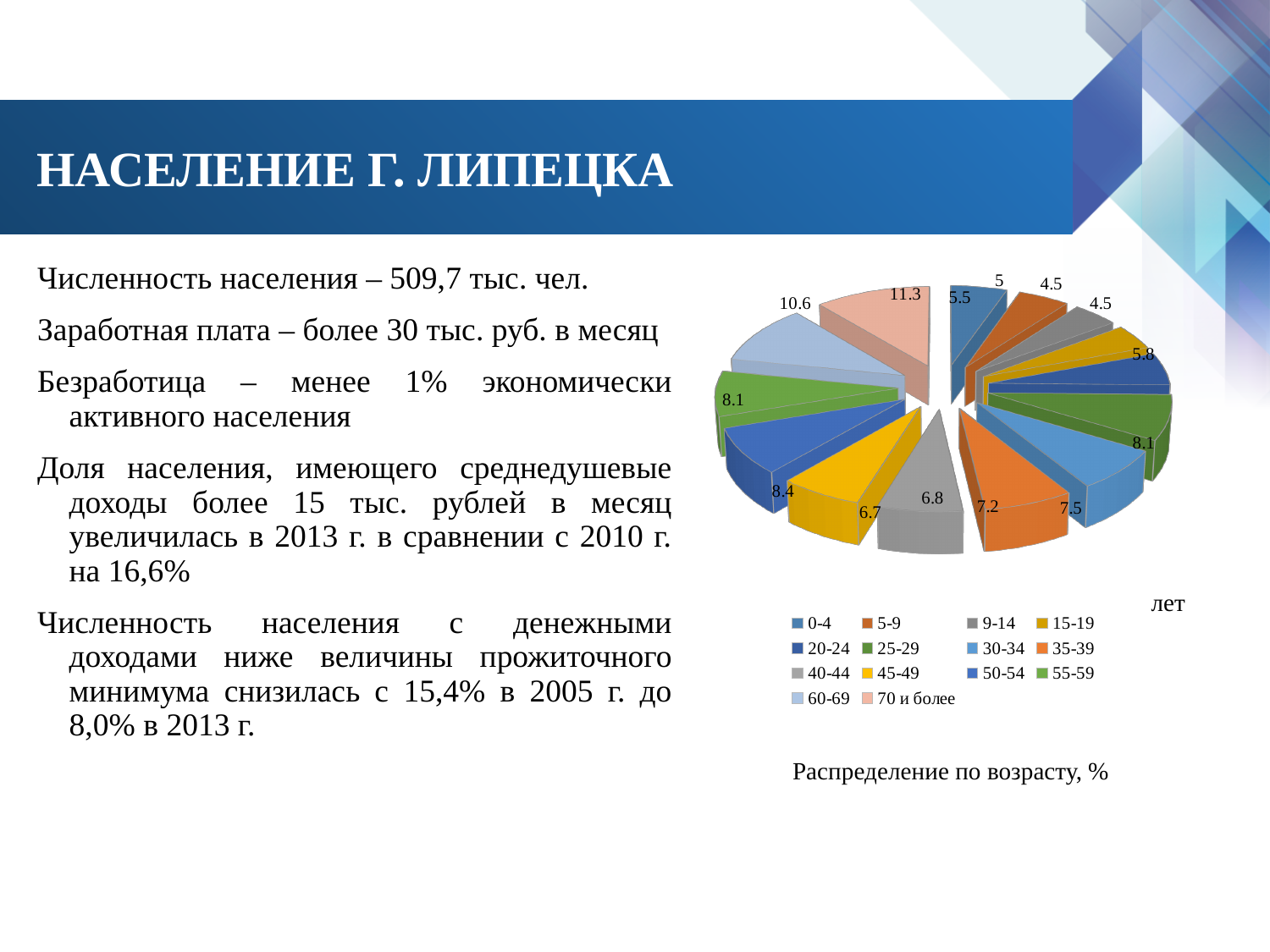
What is the value for the 60-69 age group in the pie chart? 10.6 What is the caption printed below the pie chart? Распределение по возрасту, % What is the value for the 70 и более age group in the pie chart? 11.3 Which age group has the largest slice in the pie chart? 70 и более Which is larger in the pie chart: the value for 30-34 or the value for 45-49? 30-34 What is the difference between the values for the 50-54 and 20-24 age groups? 2.6 What is the difference between the values for the 70 и более and 60-69 age groups? 0.7 How many age categories does the pie chart's legend list? 14 What kind of chart is shown on the slide? pie chart What is the value for the 50-54 age group in the pie chart? 8.4 What is the value for the 0-4 age group in the pie chart? 5.5 What is the value for the 40-44 age group in the pie chart? 6.8